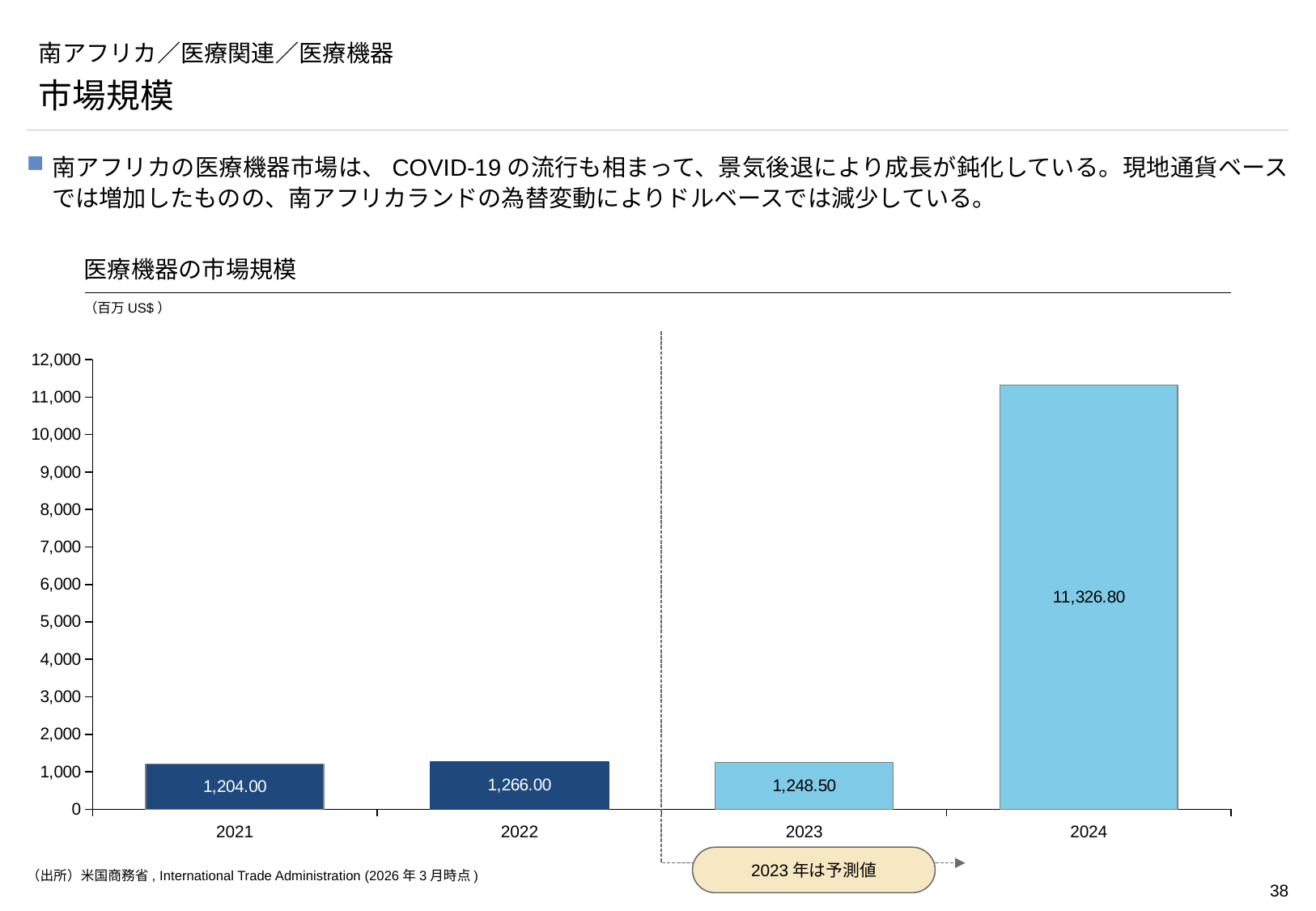
Which year has the lowest value? 2021 Is the value for 2024 greater or less than 10,000? greater What is the difference between the values for 2022 and 2021? 62.00 What is the title of the chart? 医療機器の市場規模 What kind of chart is shown? bar chart Which year has the highest value? 2024 What is the value for 2022? 1,266.00 What is the value for 2023? 1,248.50 What is the value for 2024? 11,326.80 How many years are shown on the x axis? 4 What is the value for 2021? 1,204.00 Which is larger, the value for 2022 or the value for 2023? 2022